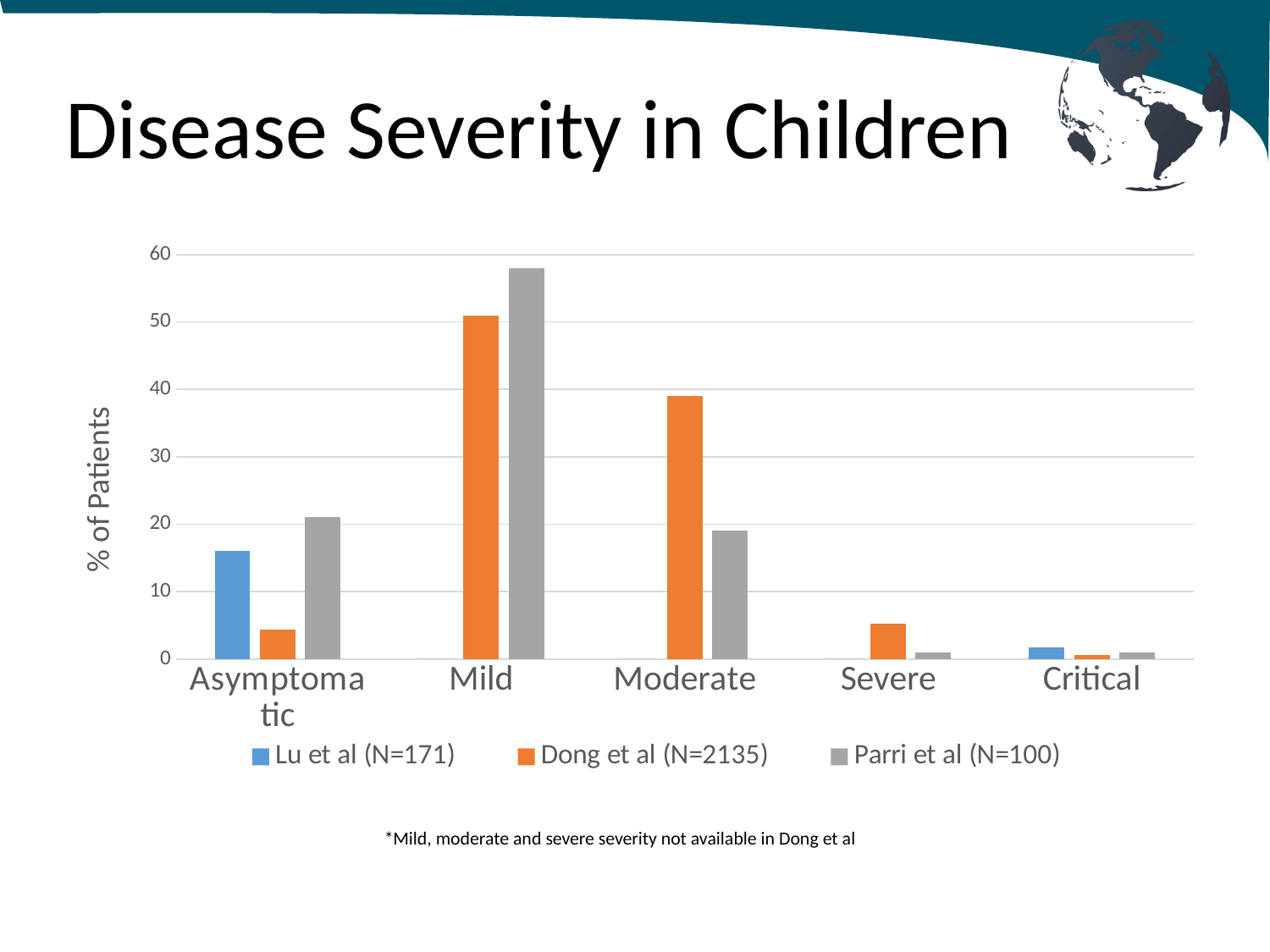
Is the value for Lu et al (N=171) in the Asymptomatic category greater or less than 20? less How many series does the legend list? 3 What kind of chart is shown on the slide? bar chart What is the title of the chart? Disease Severity in Children Is the value for Parri et al (N=100) in the Mild category greater or less than 50? greater Which category has the tallest bar for Parri et al (N=100)? Mild Which category has the tallest bar for Dong et al (N=2135)? Mild How many severity categories are shown on the x axis? 5 Is the value for Dong et al (N=2135) in the Moderate category greater or less than 30? greater What is the label of the y axis? % of Patients In the Moderate category, which series has the larger value, Dong et al (N=2135) or Parri et al (N=100)? Dong et al (N=2135)